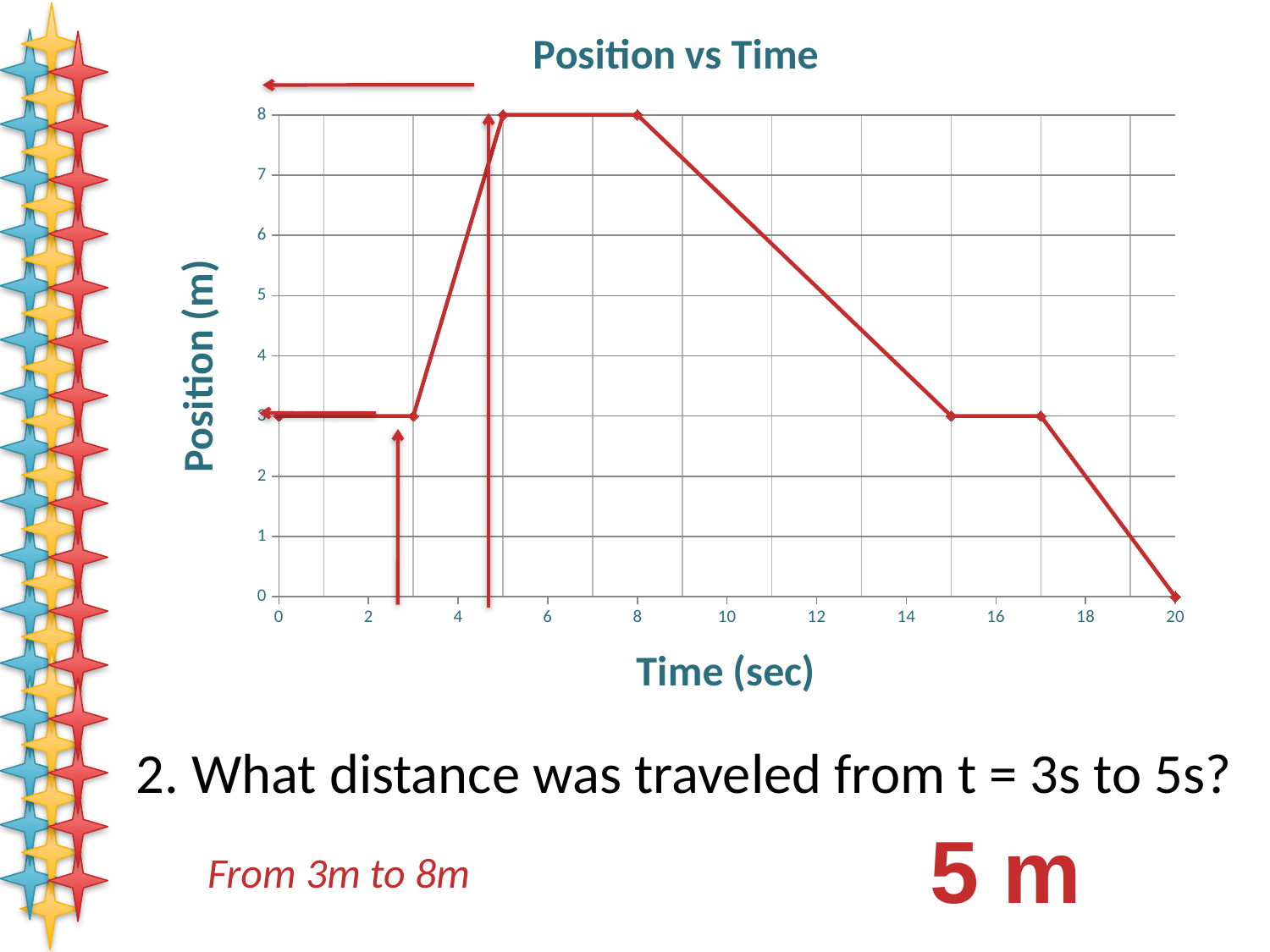
What is the position at t = 8 seconds? 8 What is the position at t = 20 seconds? 0 What is the label of the vertical axis? Position (m) How many data points are marked on the line? 7 What is the position at t = 5 seconds? 8m What kind of chart is shown on the slide? line chart What is the position at t = 0 seconds? 3 What is the highest position value reached on the chart? 8 Does the position rise or fall between t = 8 and t = 15 seconds? fall What is the position at t = 3 seconds? 3m What is the title of the chart? Position vs Time At what time does the position reach its lowest value? 20